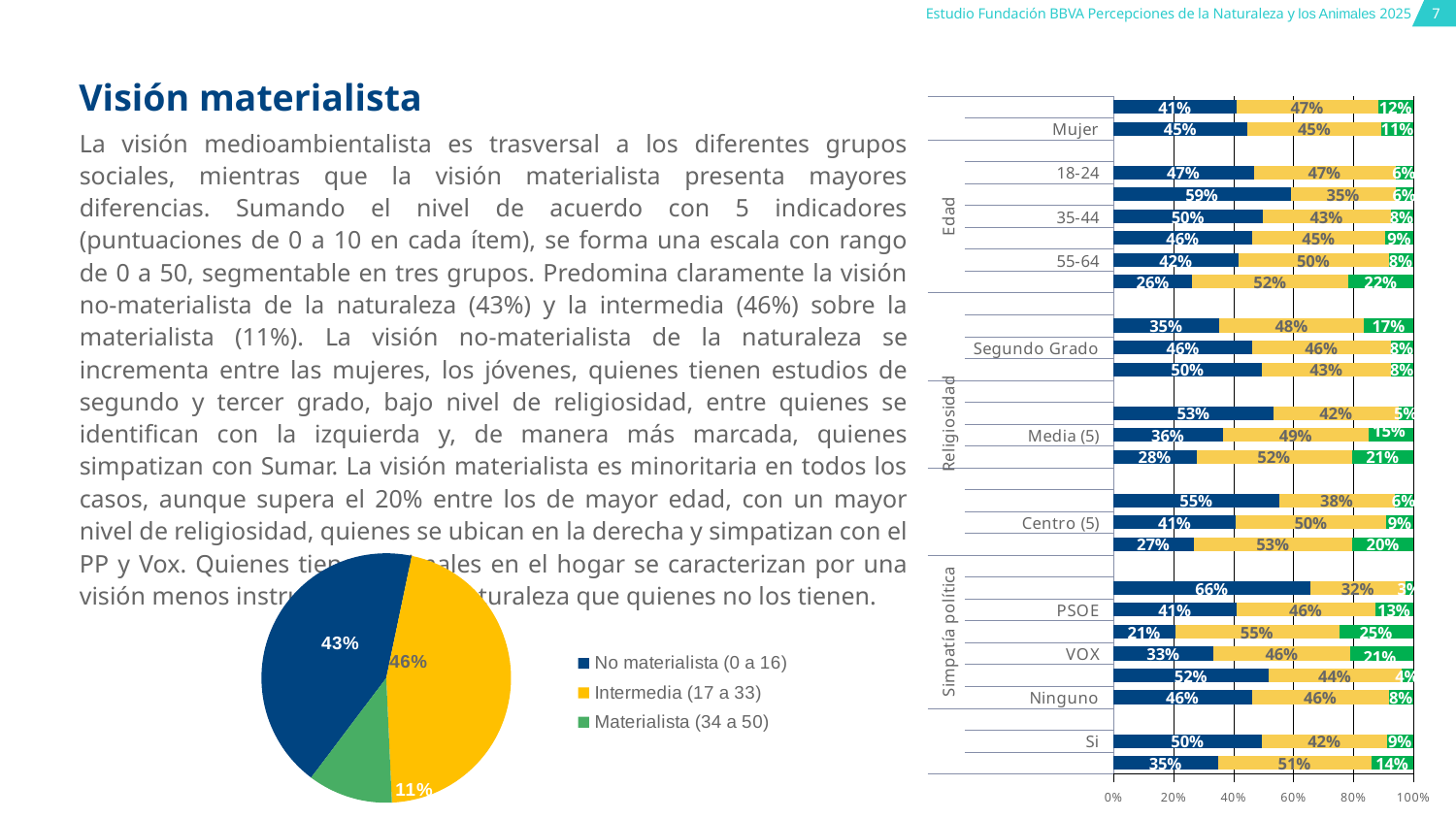
In the bar chart on the right, what is the value of the last (green) segment for 'VOX'? 21% In the pie chart, what share corresponds to 'Intermedia (17 a 33)'? 46% In the pie chart, what share corresponds to 'No materialista (0 a 16)'? 43% In the pie chart, which category has the largest slice? Intermedia (17 a 33) In the bar chart on the right, what is the value of the middle (yellow) segment for '55-64'? 50% In the bar chart on the right, what is the value of the first (blue) segment for 'Mujer'? 45% In the pie chart, what share corresponds to 'Materialista (34 a 50)'? 11% In the bar chart on the right, what is the difference between the green segment for 'VOX' (21%) and the green segment for 'PSOE' (13%)? 8% How many categories does the pie chart's legend list? 3 In the pie chart, which category has the smallest slice? Materialista (34 a 50) What kind of chart is shown at the bottom left of the slide? Pie chart What kind of chart is shown on the right side of the slide? Bar chart